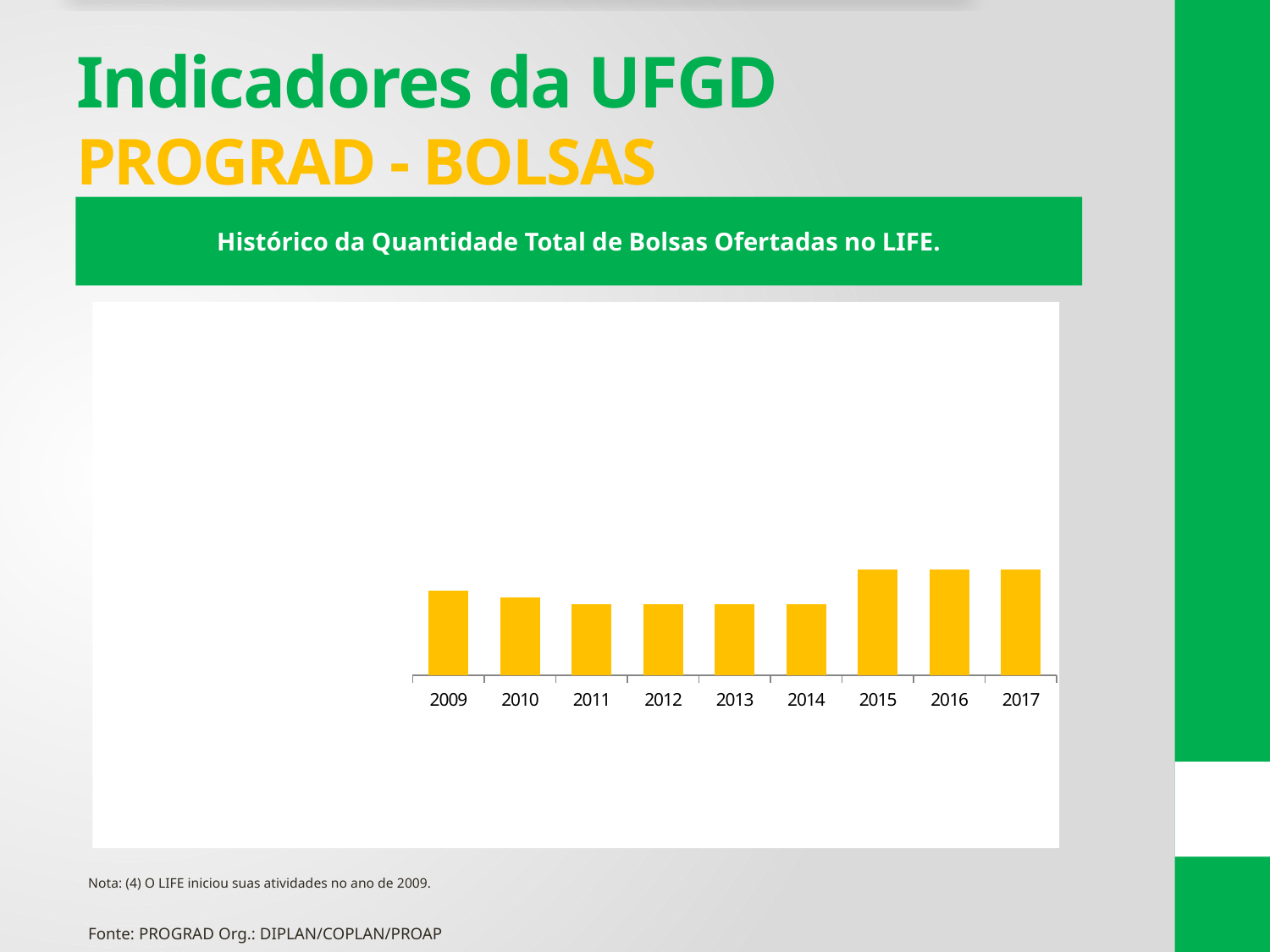
Which is larger, the value for 2010 or the value for 2017? 2017 What kind of chart is shown on the slide? bar chart Do the values rise or fall from 2014 to 2015? rise Which is larger, the value for 2009 or the value for 2011? 2009 Do the values rise or fall from 2009 to 2014? fall Which is larger, the value for 2014 or the value for 2016? 2016 How many years are shown on the x axis of the chart? 9 What is the first year shown on the x axis of the chart? 2009 What is the last year shown on the x axis of the chart? 2017